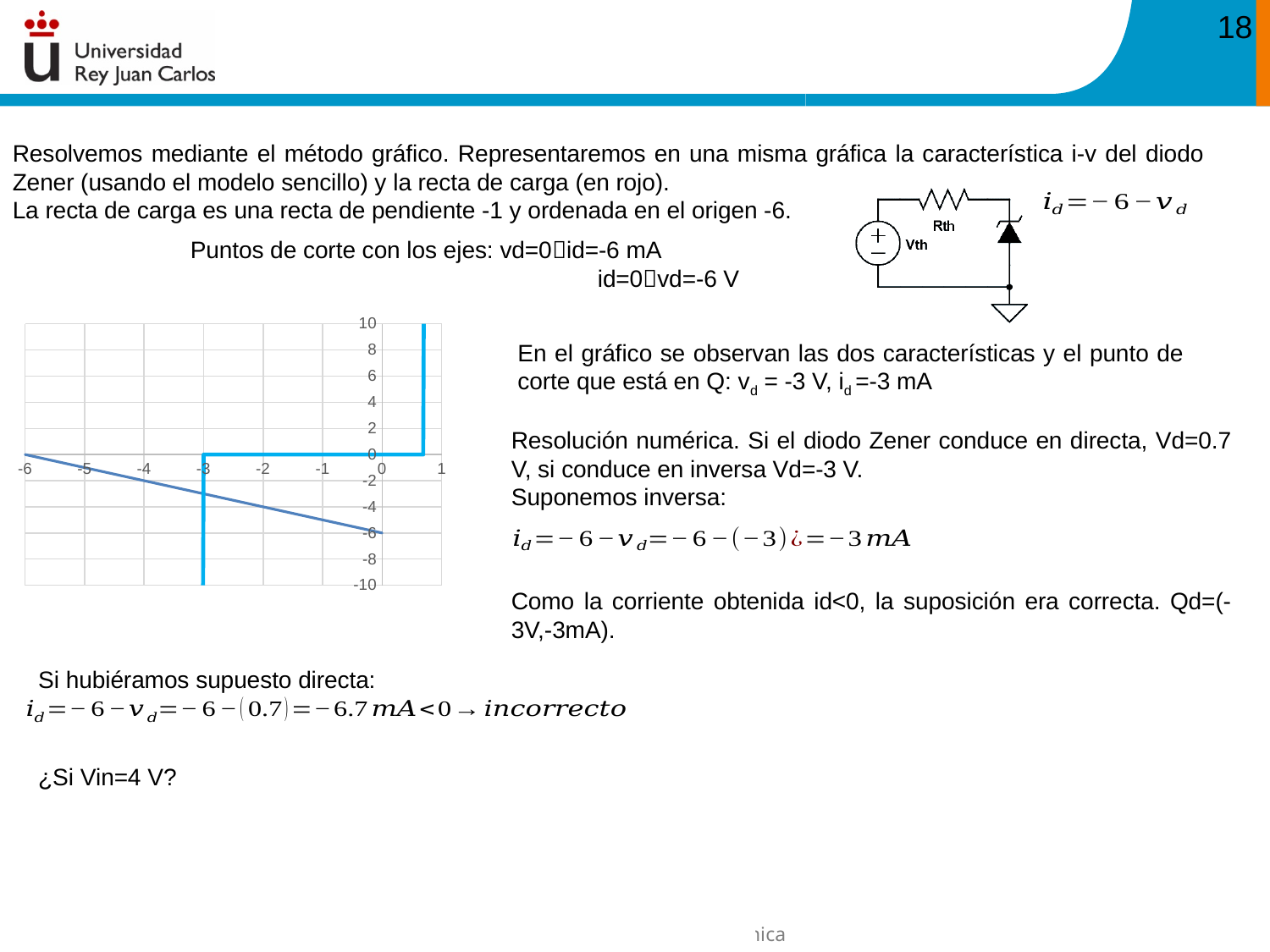
What is the value of the dark blue load line at x = 0? -6 Is the value of the dark blue load line at x = -3 greater or less than -6? greater What is the value of the dark blue load line at x = -6? 0 At x = -1, which line is higher, the light blue line or the dark blue line? the light blue line Is the value of the dark blue load line at x = -3 greater or less than 0? less What kind of chart is shown on the slide? line chart Does the dark blue load line rise or fall as x increases? falls How many lines are plotted on the chart? 2 What is the lowest value shown on the x axis of the chart? -6 At which x value does the light blue line have its vertical segment going down to -10? -3 What is the highest value shown on the y axis of the chart? 10 What is the spacing between consecutive tick labels on the y axis? 2